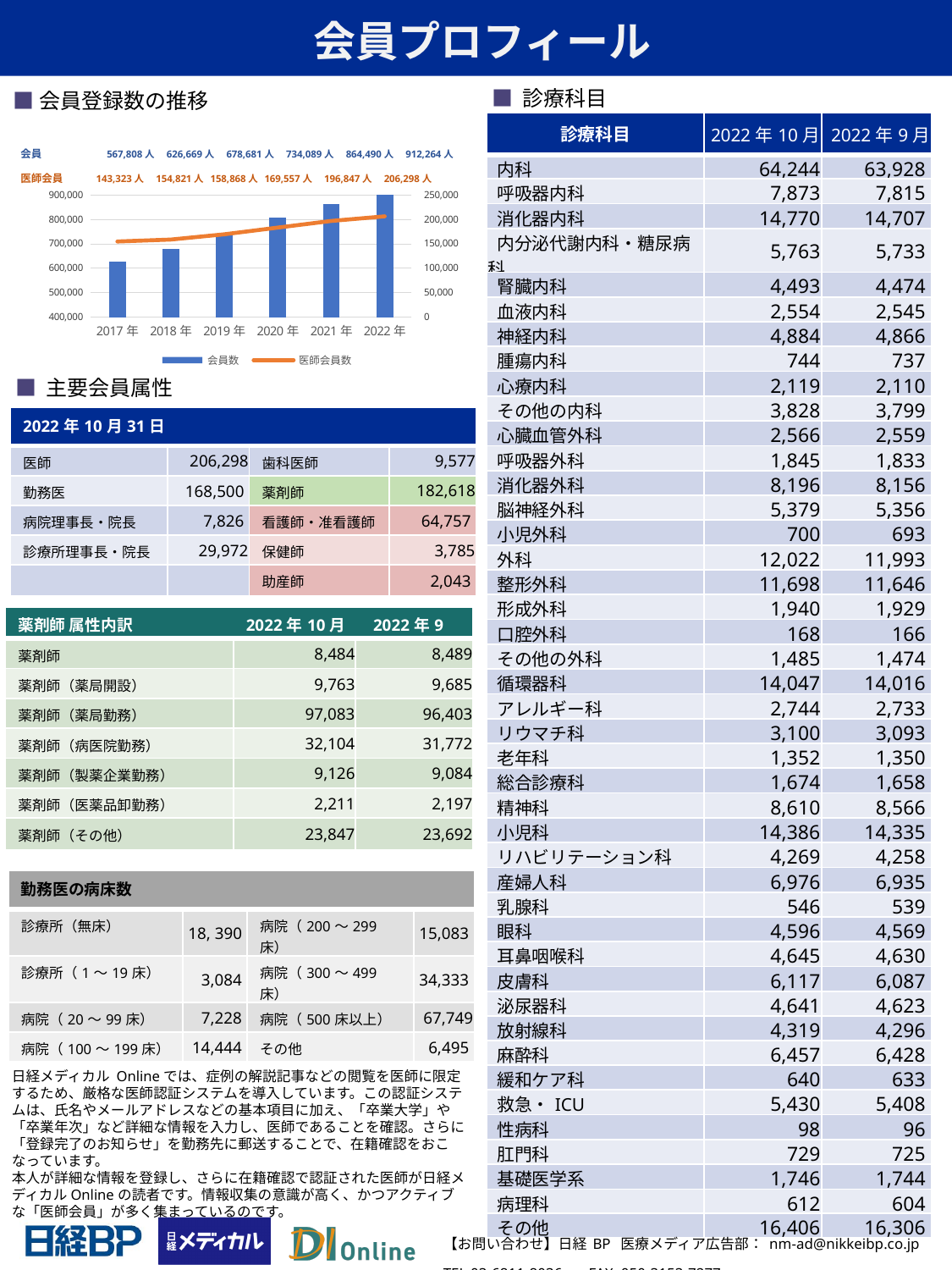
In the 会員登録数の推移 chart, is the 会員 value for 2021年 larger or smaller than the value for 2020年? larger How many years are shown on the x axis of the 会員登録数の推移 chart? 6 In the 会員登録数の推移 chart, what is the 会員 value for 2022年? 912,264人 How many series does the legend of the 会員登録数の推移 chart list? 2 In the 会員登録数の推移 chart, which year has the highest 会員数? 2022年 In the 会員登録数の推移 chart, is the 会員数 bar for 2020年 greater or less than 700,000? greater What kind of chart is shown under 会員登録数の推移? A bar chart combined with a line In the 会員登録数の推移 chart, what is the difference between the 医師会員 values for 2022年 and 2021年? 9,451人 In the 会員登録数の推移 chart, which year has the lowest 医師会員数? 2017年